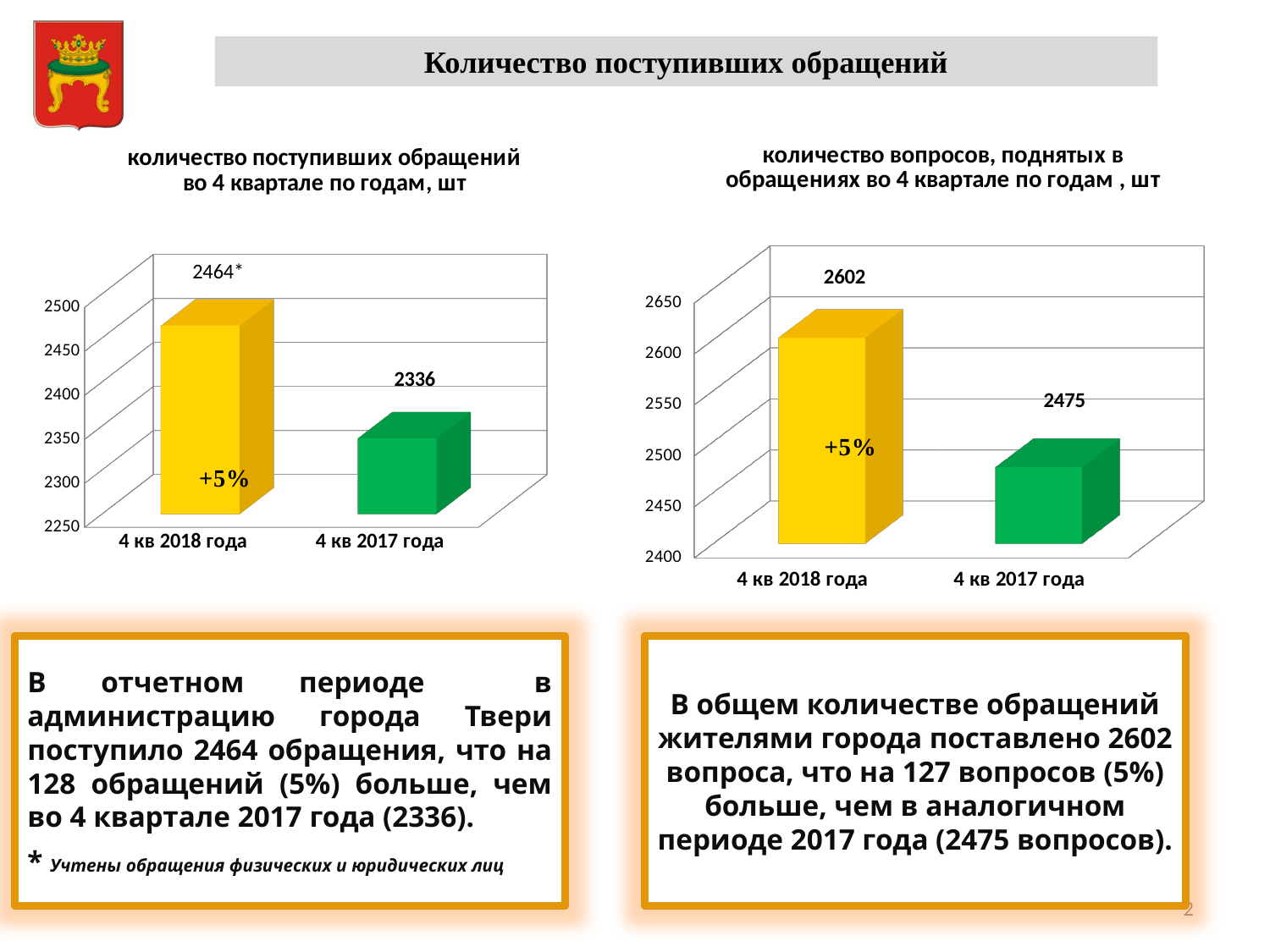
In the right chart, which is larger: the value for 4 кв 2018 года or for 4 кв 2017 года? 4 кв 2018 года What percentage change label is printed on the 4 кв 2018 года bar in the left chart? +5% In the right chart (количество вопросов, поднятых в обращениях во 4 квартале по годам, шт), what is the value for 4 кв 2018 года? 2602 In the right chart, which category has the lowest value? 4 кв 2017 года In the left chart, which category has the highest value? 4 кв 2018 года In the right chart, what is the difference between the values for 4 кв 2018 года and 4 кв 2017 года? 127 In the left chart (количество поступивших обращений во 4 квартале по годам, шт), what is the value for 4 кв 2017 года? 2336 How many categories are shown in the left chart? 2 In the left chart (количество поступивших обращений во 4 квартале по годам, шт), what is the value for 4 кв 2018 года? 2464 In the right chart (количество вопросов, поднятых в обращениях во 4 квартале по годам, шт), what is the value for 4 кв 2017 года? 2475 What type of chart is the right chart? Bar chart In the left chart, what is the difference between the values for 4 кв 2018 года and 4 кв 2017 года? 128